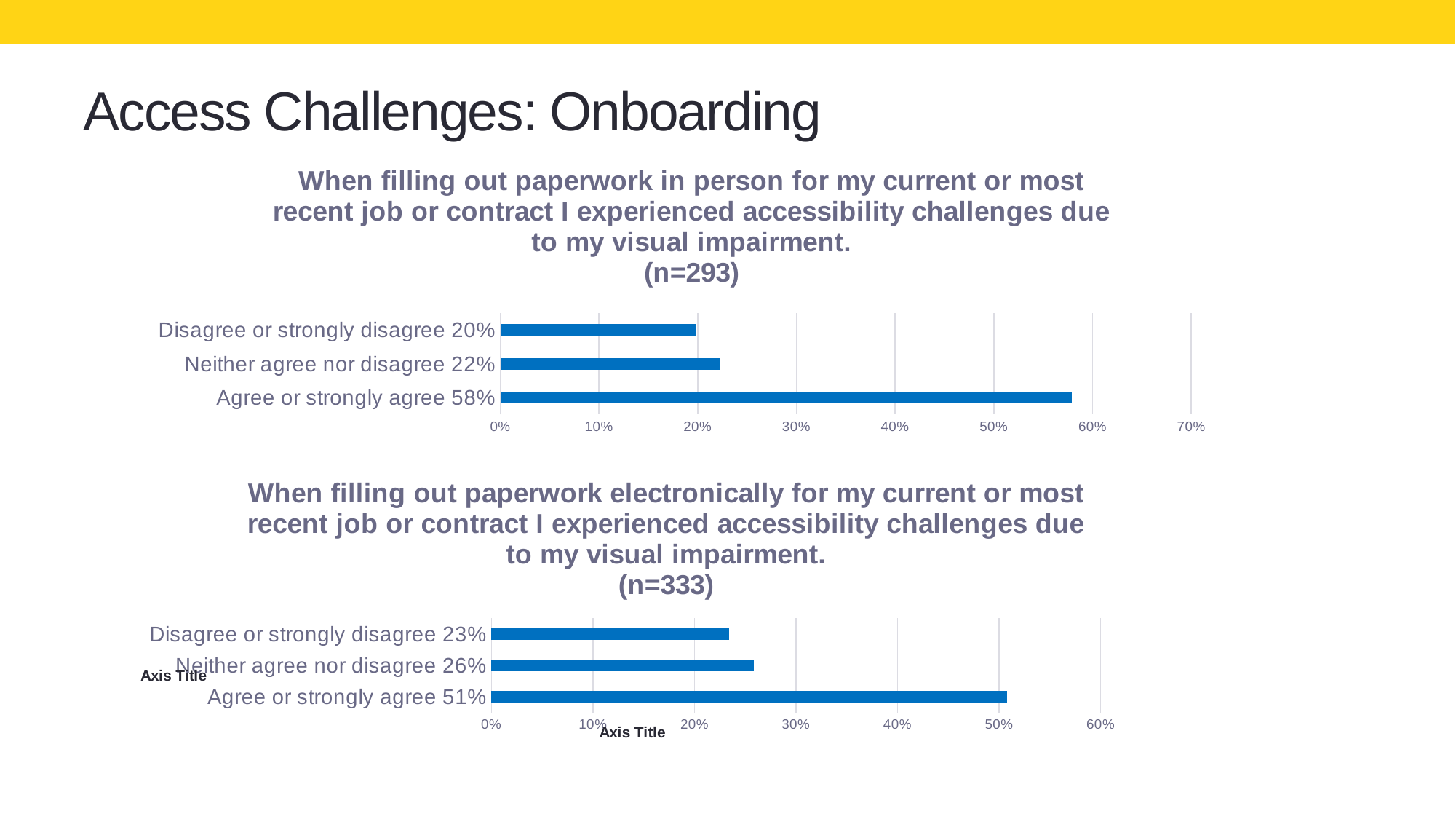
How many response categories are shown in the top chart (in-person paperwork, n=293)? 3 In the bottom chart (electronic paperwork, n=333), what percentage of respondents disagree or strongly disagree? 23% In the top chart (in-person paperwork, n=293), what percentage of respondents agree or strongly agree? 58% What type of chart is the bottom chart (electronic paperwork, n=333)? Bar chart In the top chart (in-person paperwork, n=293), what percentage of respondents neither agree nor disagree? 22% In the top chart (in-person paperwork, n=293), which response category has the highest percentage? Agree or strongly agree In the bottom chart (electronic paperwork, n=333), which response category has the lowest percentage? Disagree or strongly disagree In the bottom chart (electronic paperwork, n=333), what is the difference in percentage points between 'Neither agree nor disagree' and 'Disagree or strongly disagree'? 3 percentage points What is the sample size (n) stated in the title of the top chart about in-person paperwork? n=293 In the top chart (in-person paperwork, n=293), what is the difference in percentage points between 'Agree or strongly agree' and 'Disagree or strongly disagree'? 38 percentage points In the bottom chart (electronic paperwork, n=333), what percentage of respondents agree or strongly agree? 51% Which chart shows a higher percentage for 'Agree or strongly agree': the top chart (in-person, n=293) or the bottom chart (electronic, n=333)? The top chart (in-person, n=293)